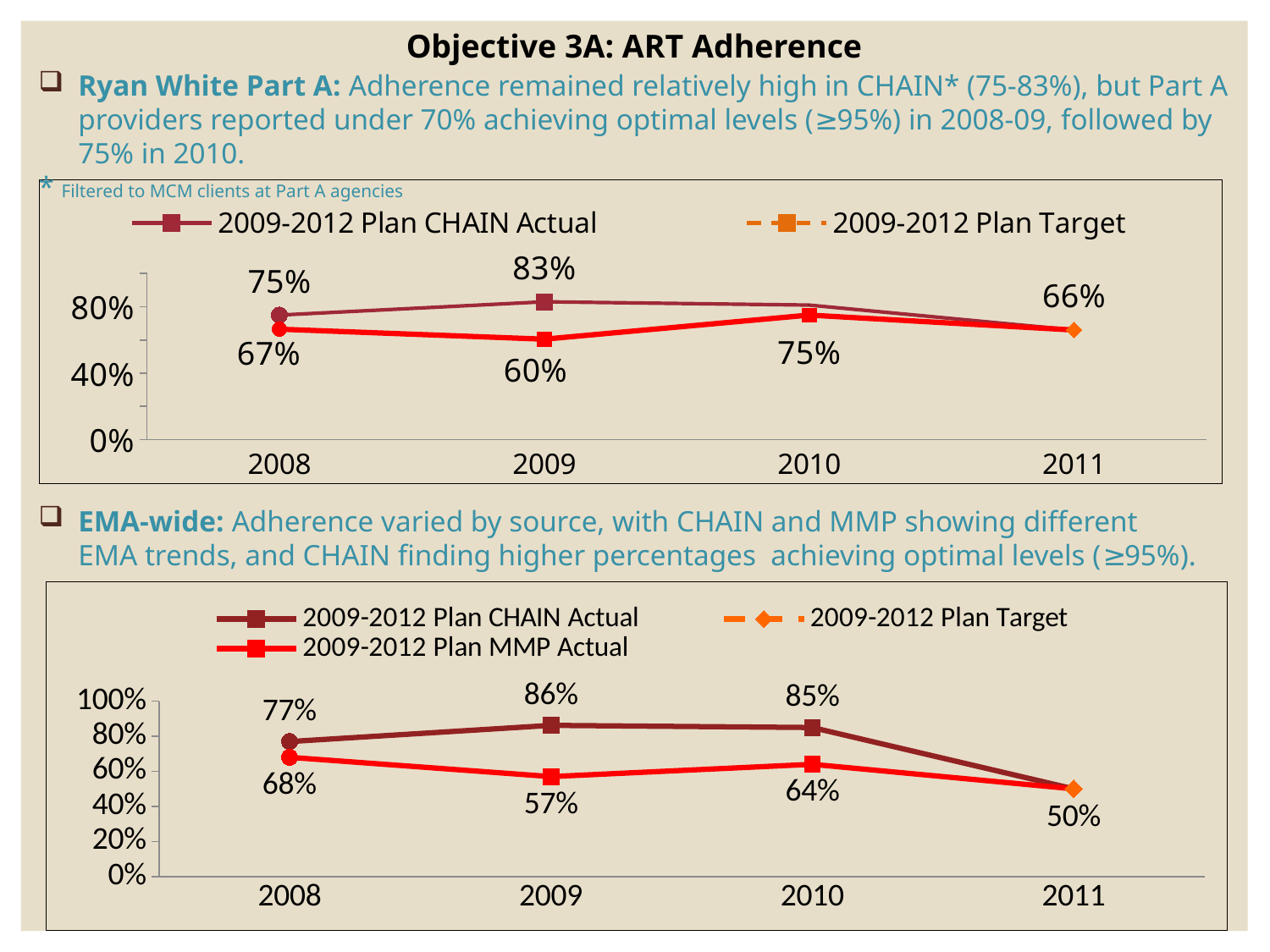
In the bottom chart (EMA-wide), what is the 2009-2012 Plan CHAIN Actual value for 2009? 86% In the top chart (Ryan White Part A), how many years are shown on the x axis? 4 What kind of chart is the top chart (Ryan White Part A)? Line chart In the bottom chart (EMA-wide), how many series does the legend list? 3 In the top chart (Ryan White Part A), what is the 2009-2012 Plan CHAIN Actual value for 2009? 83% In the bottom chart (EMA-wide), what is the 2009-2012 Plan Target value shown for 2011? 50% In the bottom chart (EMA-wide), what is the 2009-2012 Plan MMP Actual value for 2009? 57% In the top chart (Ryan White Part A), by how much did the CHAIN Actual value increase from 2008 to 2009? 8 percentage points In the bottom chart (EMA-wide), what is the difference between the CHAIN Actual and MMP Actual values in 2009? 29 percentage points In the bottom chart (EMA-wide), in which year is the 2009-2012 Plan MMP Actual value lowest? 2011 In the top chart (Ryan White Part A), what is the 2009-2012 Plan Target value shown for 2011? 66% In the bottom chart (EMA-wide), which is larger in 2008: the CHAIN Actual value or the MMP Actual value? CHAIN Actual